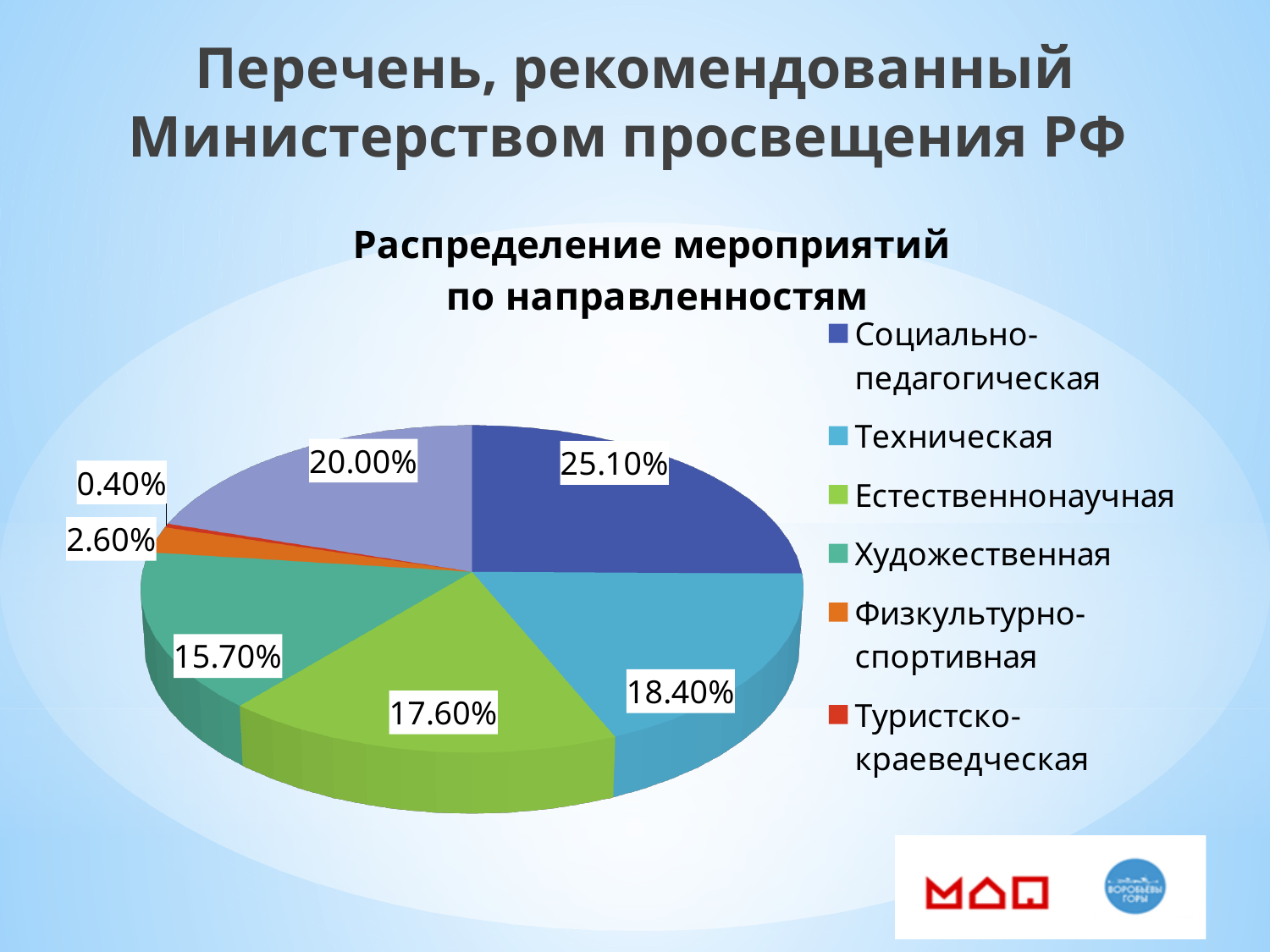
Which has a larger share, Естественнонаучная or Художественная? Естественнонаучная What is the share for Художественная? 15.70% What is the title of the chart? Распределение мероприятий по направленностям Which category has the largest share in the pie chart? Социально-педагогическая Which category has the smallest share in the pie chart? Туристско-краеведческая What is the difference between the shares of Социально-педагогическая and Техническая? 6.70% What is the share for Техническая? 18.40% What is the share for Физкультурно-спортивная? 2.60% What is the share for Естественнонаучная? 17.60% What is the share for Социально-педагогическая? 25.10% What kind of chart is shown on the slide? pie chart What is the share for Туристско-краеведческая? 0.40%